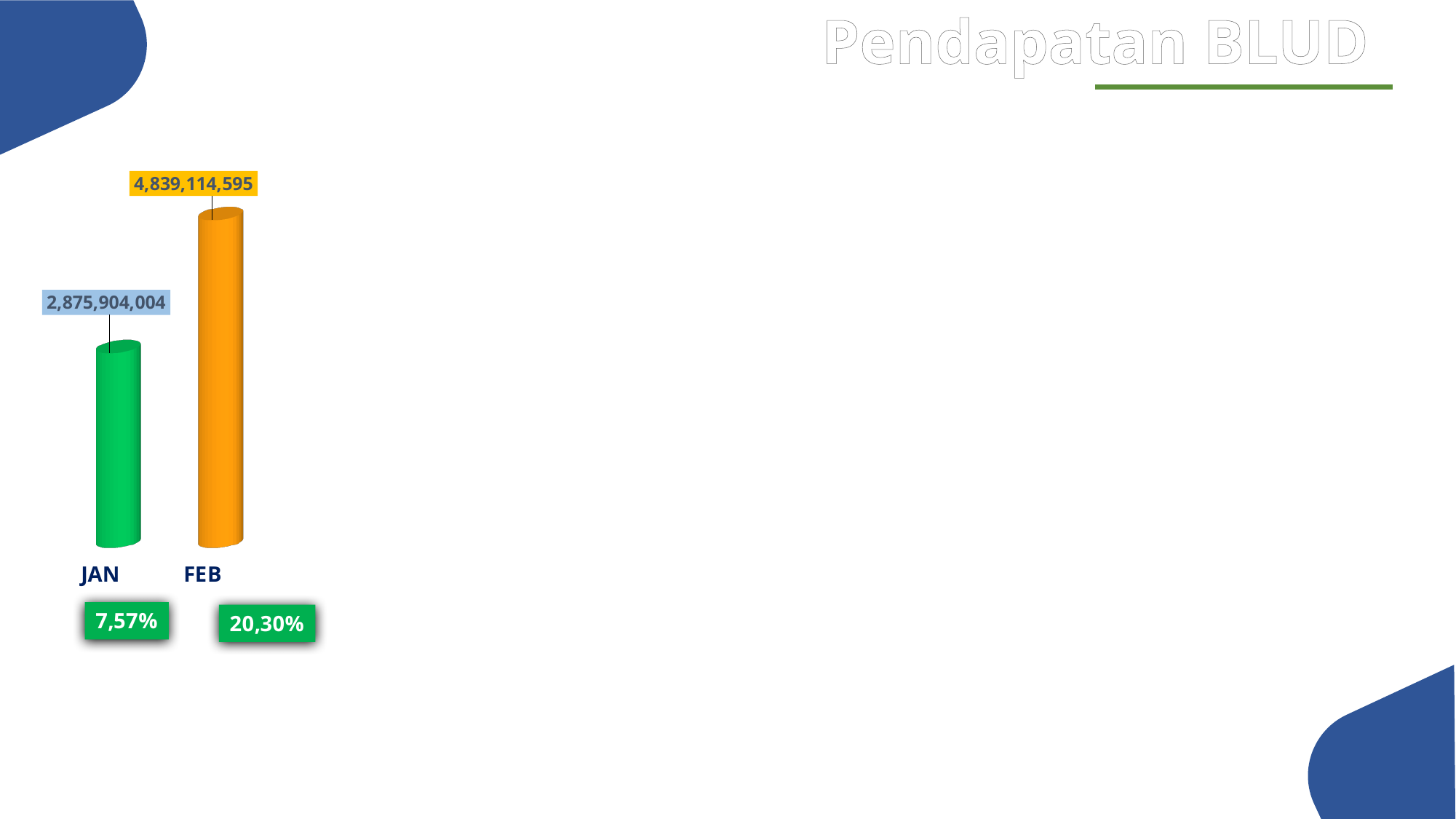
What is the value for FEB? 4,839,114,595 Which is larger, the value for JAN or the value for FEB? FEB What is the title of the slide containing the chart? Pendapatan BLUD How many categories are shown in the chart? 2 Which month has the highest value? FEB What is the value for JAN? 2,875,904,004 What kind of chart is shown on the slide? Bar chart Do the values rise or fall from JAN to FEB? Rise What percentage is shown below the FEB bar? 20,30% What is the difference between the FEB and JAN values? 1,963,210,591 Which month has the lowest value? JAN What is the total of the JAN and FEB values? 7,715,018,599